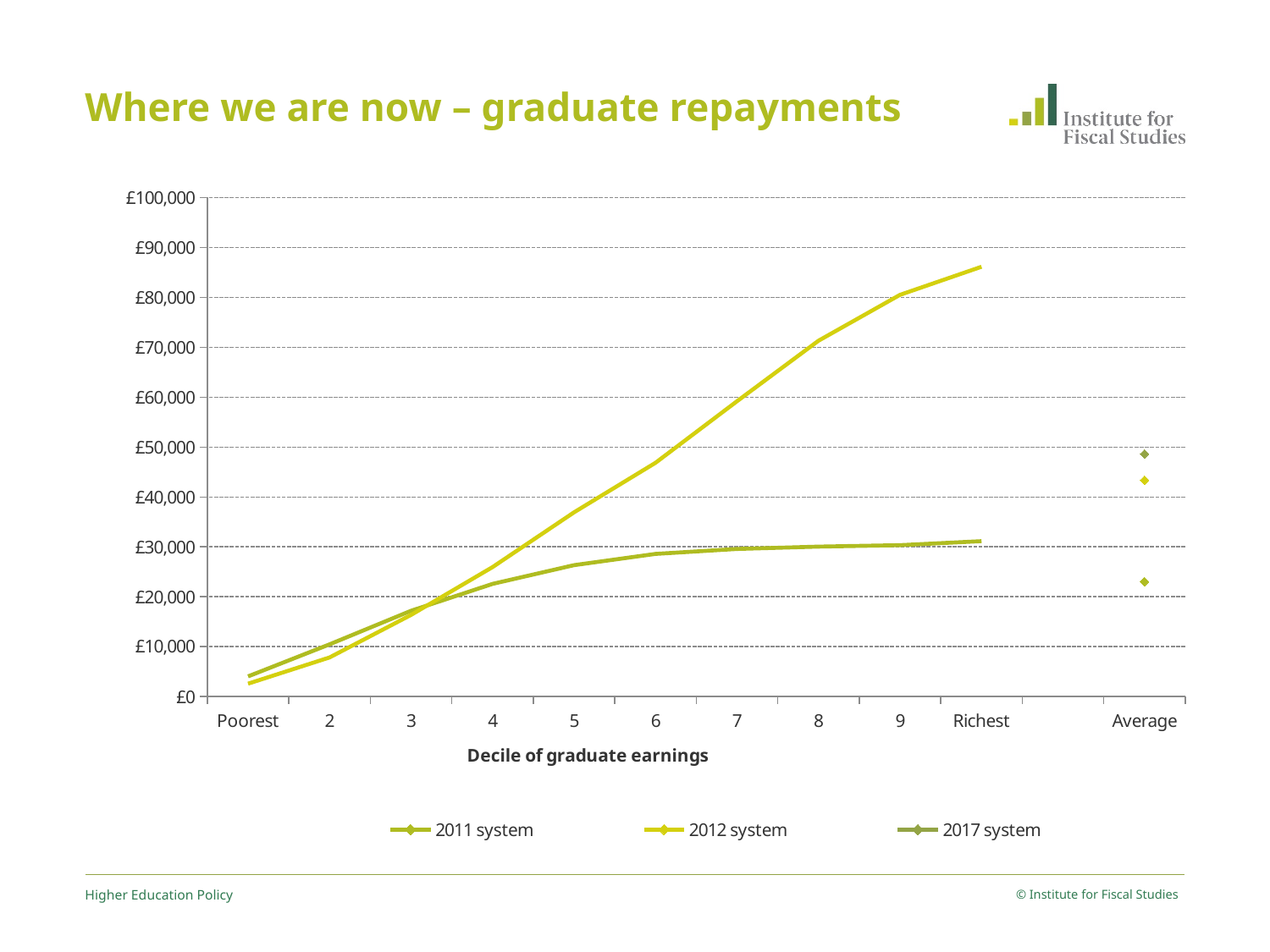
Is the highest line's value at Richest greater or less than £80,000? greater Is the lowest Average point greater or less than £30,000? less Do the plotted lines rise or fall from Poorest to Richest? rise What is the title of the chart on the slide? Where we are now – graduate repayments How many categories are labelled along the x axis, including Average? 11 How many series does the legend list? 3 Is the highest Average point greater or less than £40,000? greater What are the three series named in the legend? 2011 system, 2012 system, 2017 system What kind of chart is shown on the slide? Line chart What is the label of the x axis? Decile of graduate earnings